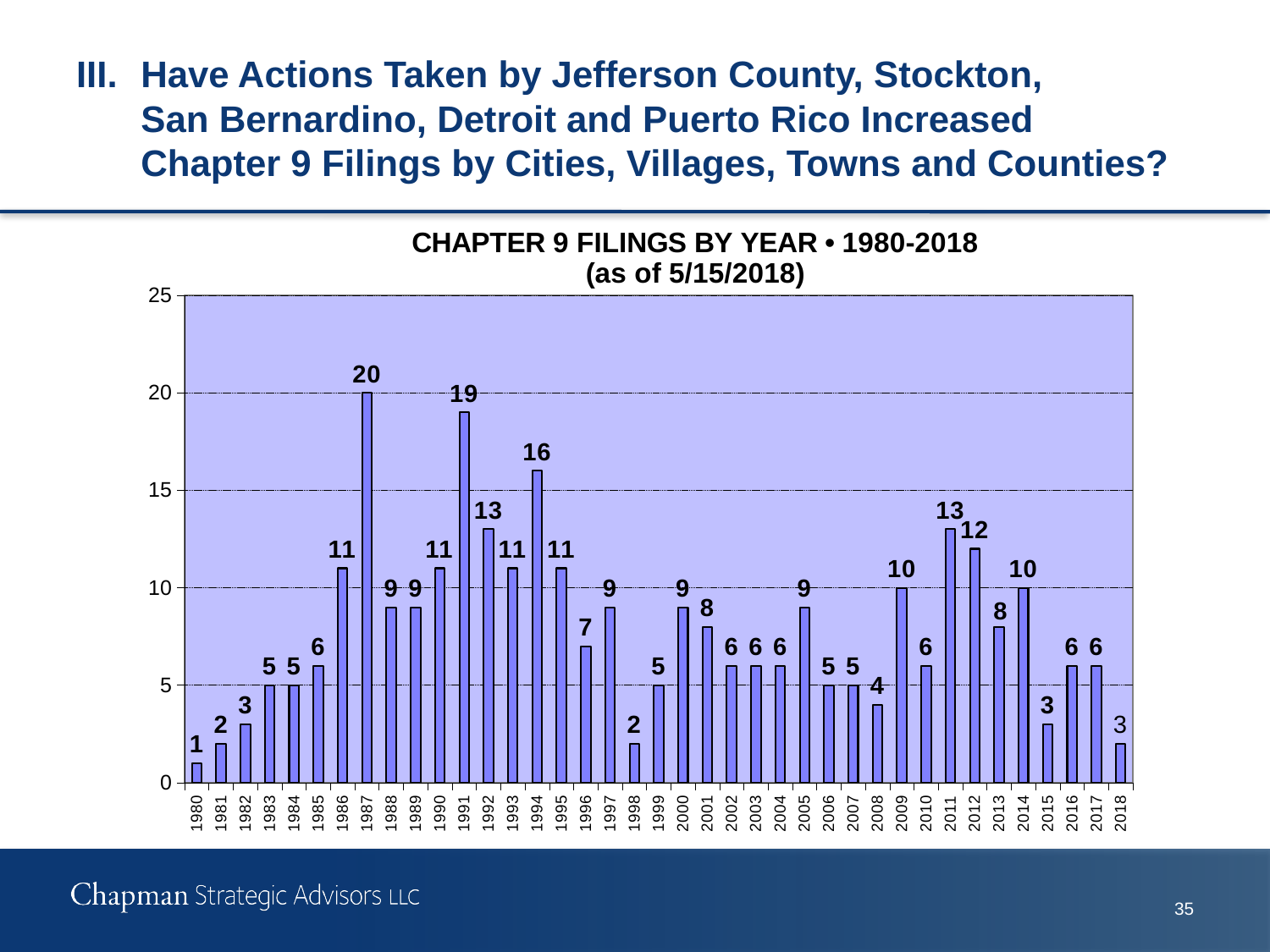
What is the difference between the number of filings in 1991 and in 1994? 3 Which year had the lowest number of Chapter 9 filings? 1980 How many years are shown on the x axis of the chart? 39 What kind of chart is shown on the slide? Bar chart Do the values rise or fall from 1980 to 1987? Rise Which year had more Chapter 9 filings, 2009 or 2011? 2011 How many Chapter 9 filings were there in 2018? 3 Is the value for 1994 greater or less than 15? greater How many Chapter 9 filings were there in 1987? 20 What is the title of the chart? CHAPTER 9 FILINGS BY YEAR • 1980-2018 (as of 5/15/2018) How many Chapter 9 filings were there in 2012? 12 Which year had the highest number of Chapter 9 filings? 1987